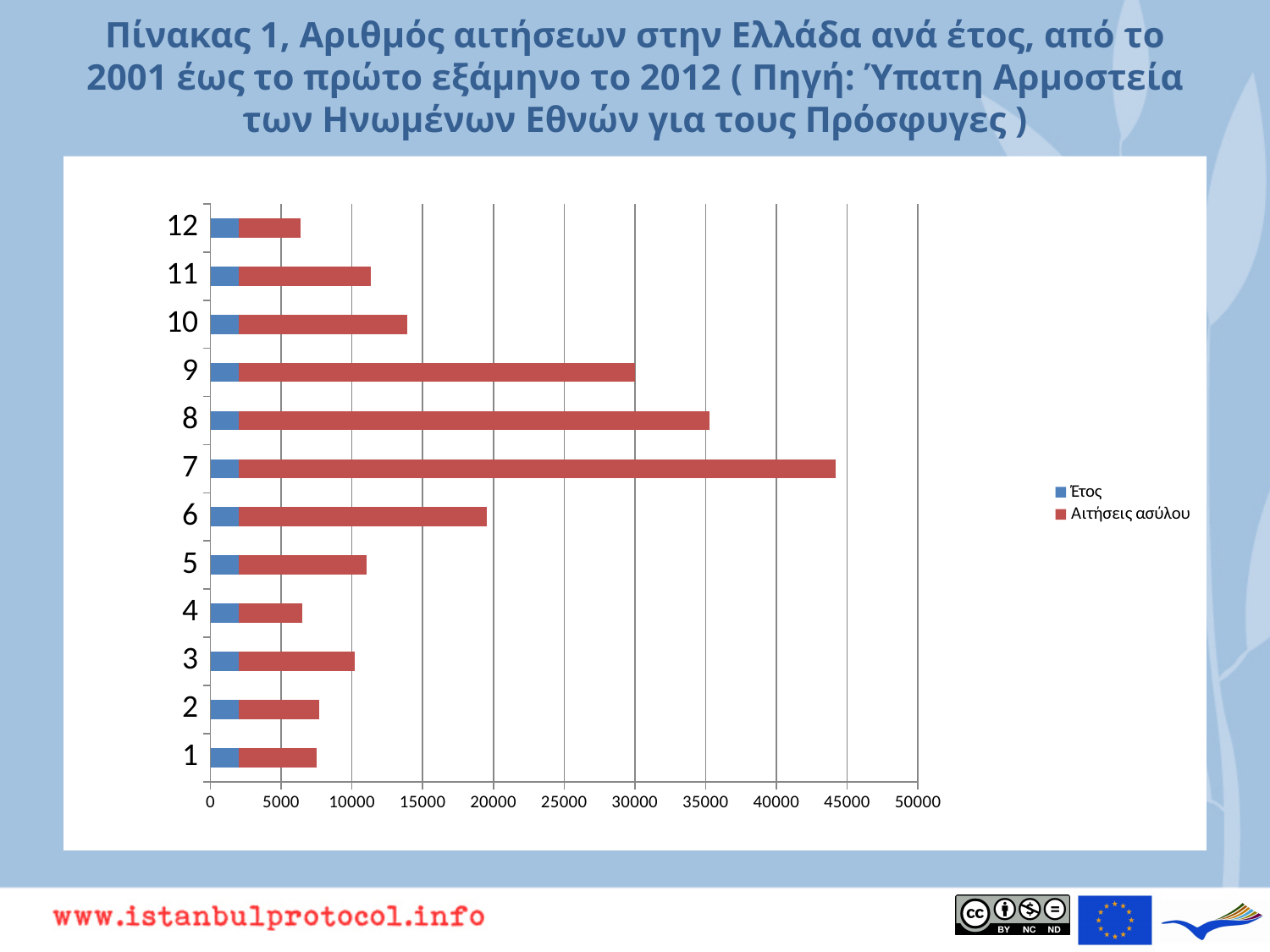
How many categories are shown on the vertical axis of the chart? 12 Do the bar lengths rise or fall going from category 7 up to category 12? fall Is the total bar length for category 10 greater or less than 15000? less Which has the longer bar, category 10 or category 11? 10 What kind of chart is shown on the slide? Bar chart Is the total bar length for category 7 greater or less than 40000? greater What colour represents the series 'Αιτήσεις ασύλου' in the chart? Red Is the total bar length for category 6 greater or less than 25000? less Which category has the longest bar in the chart? 7 How many series does the legend list? 2 Which has the longer bar, category 8 or category 9? 8